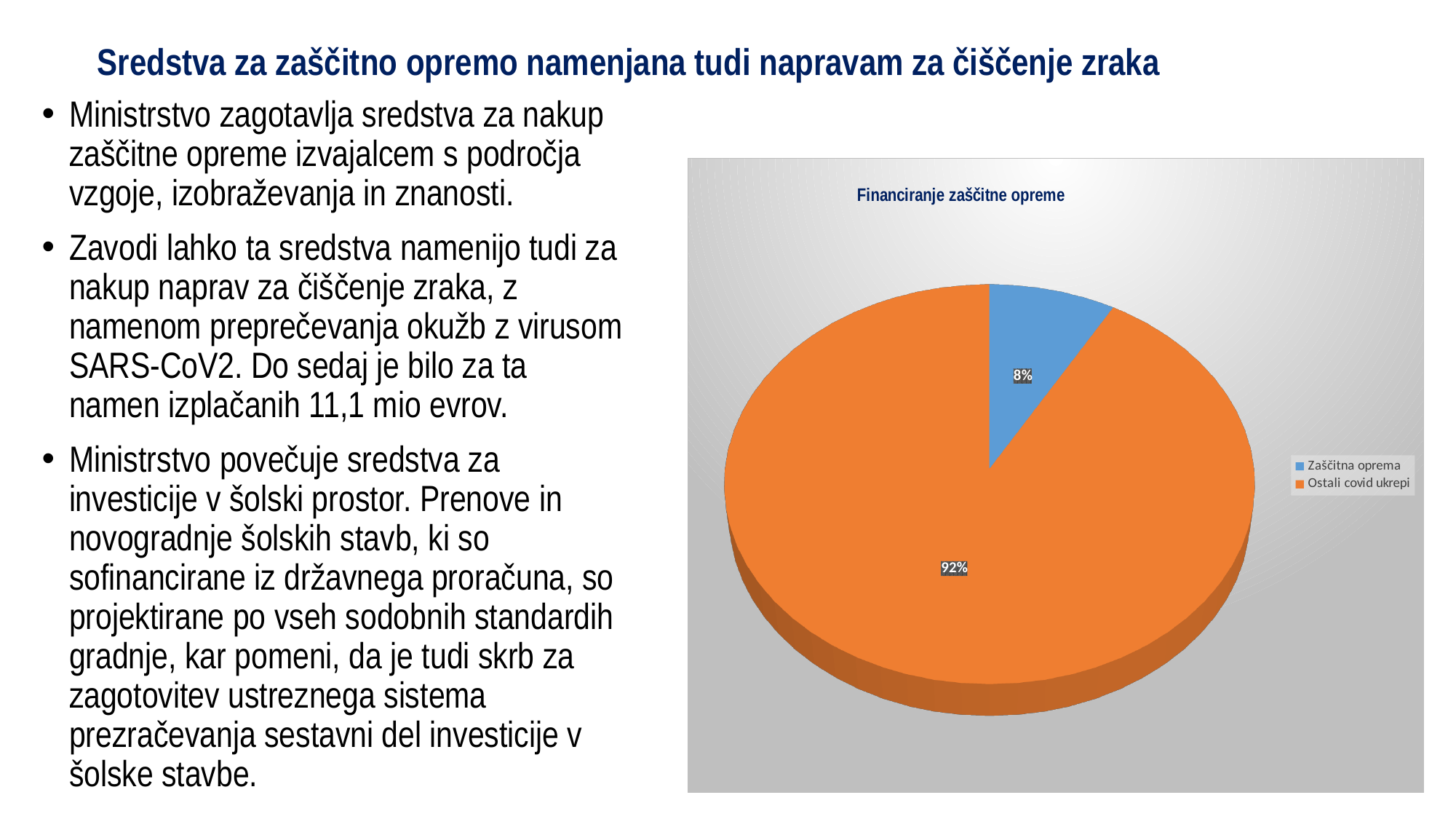
How many slices does the pie chart have? 2 What is the title of the chart? Financiranje zaščitne opreme How many entries does the legend list? 2 Which slice of the pie is the smallest? Zaščitna oprema What share of the pie does Ostali covid ukrepi represent? 92% Which is larger: the share for Zaščitna oprema or the share for Ostali covid ukrepi? Ostali covid ukrepi What share of the pie does Zaščitna oprema represent? 8% What kind of chart is shown on the slide? Pie chart What colour is the Zaščitna oprema slice? Blue What is the difference in percentage points between Ostali covid ukrepi and Zaščitna oprema? 84 Which slice of the pie is the largest? Ostali covid ukrepi